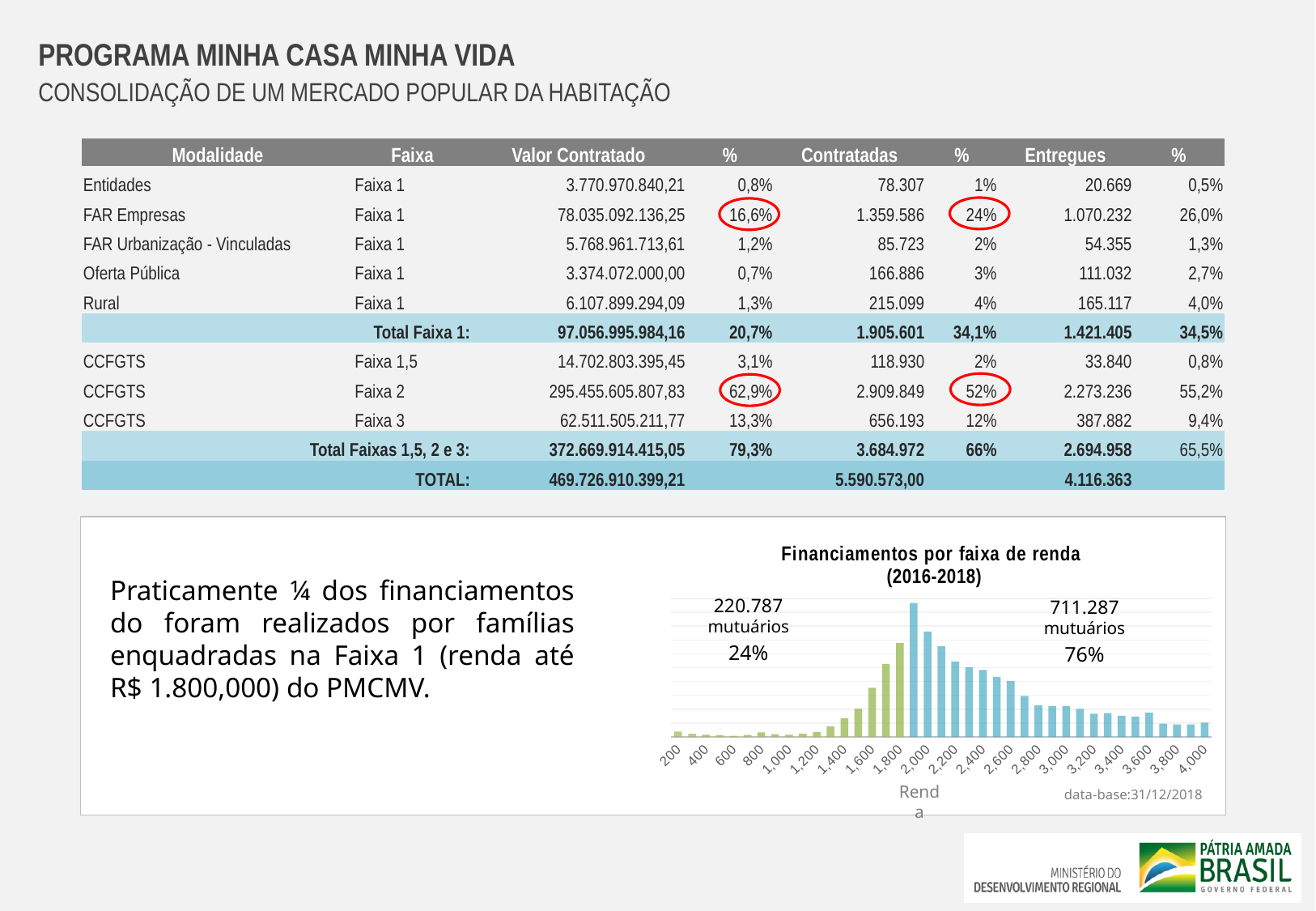
According to the annotation on the chart, how many mutuários are in the green (left) group of bars? 220.787 Do the bars in the chart rise or fall as the x axis goes from 1,200 to 2,000? rise Which bar is taller in the chart, the one at 2,000 or the one at 4,000? 2,000 What percentage share does the chart annotation give for the blue group of bars? 76% What label is shown on the x axis of the chart? Renda How many tick labels are shown along the x axis of the chart? 20 Do the bars in the chart rise or fall as the x axis goes from 2,000 to 4,000? fall According to the annotation on the chart, how many mutuários are in the blue (right) group of bars? 711.287 What kind of chart is shown on the slide? bar chart What is the title of the chart on the slide? Financiamentos por faixa de renda (2016-2018) What percentage share does the chart annotation give for the green group of bars? 24%